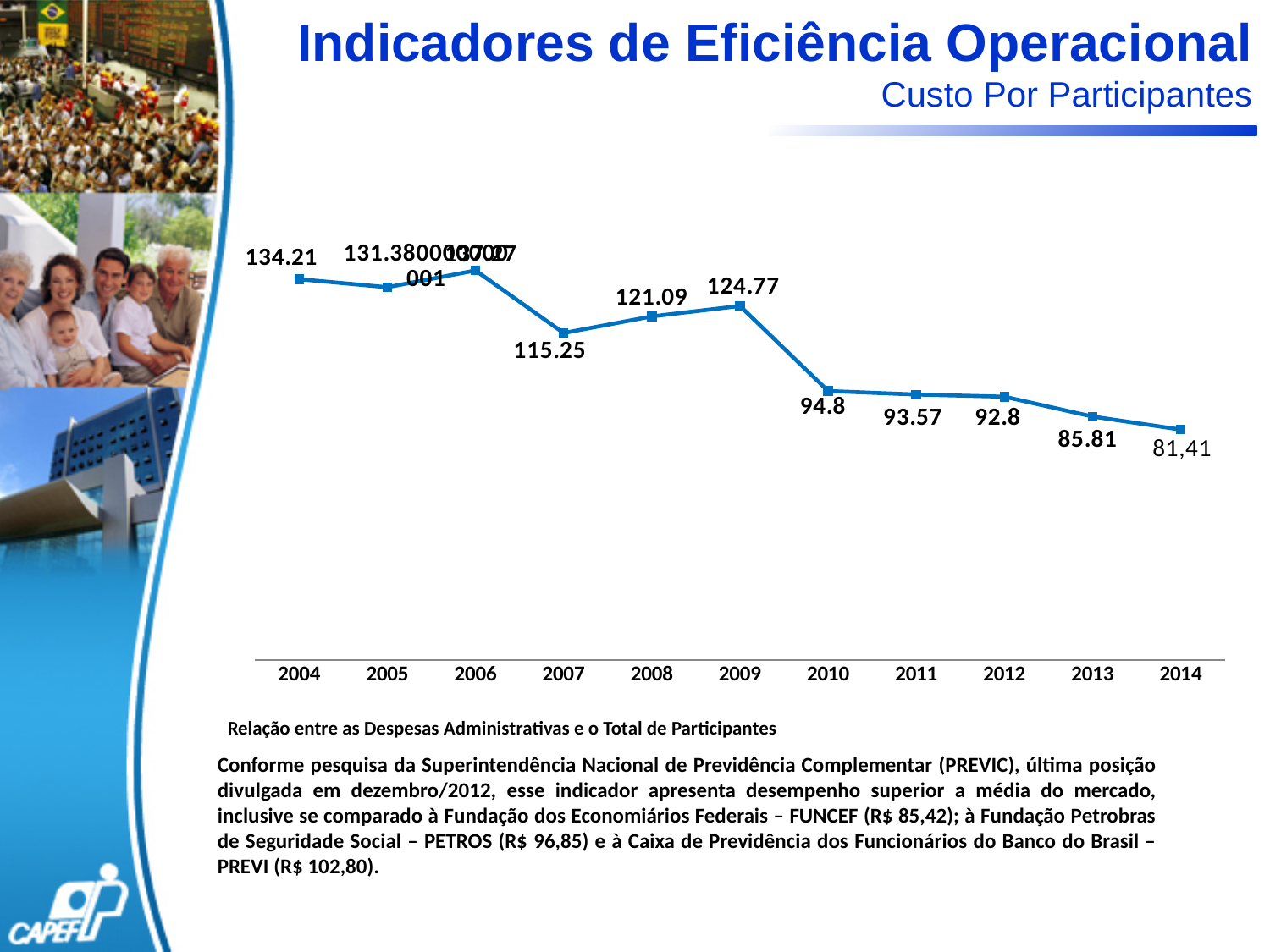
What kind of chart is shown on the slide? line chart What is the value for 2010? 94.8 What is the value for 2013? 85.81 What is the value for 2014? 81,41 Which year has the lowest value? 2014 What is the difference between the values for 2009 and 2010? 29.97 What is the value for 2004? 134.21 What is the value for 2009? 124.77 Do the values generally rise or fall from 2004 to 2014? fall What is the value for 2007? 115.25 Which is larger, the value for 2008 or the value for 2009? 2009 How many years are plotted on the chart? 11